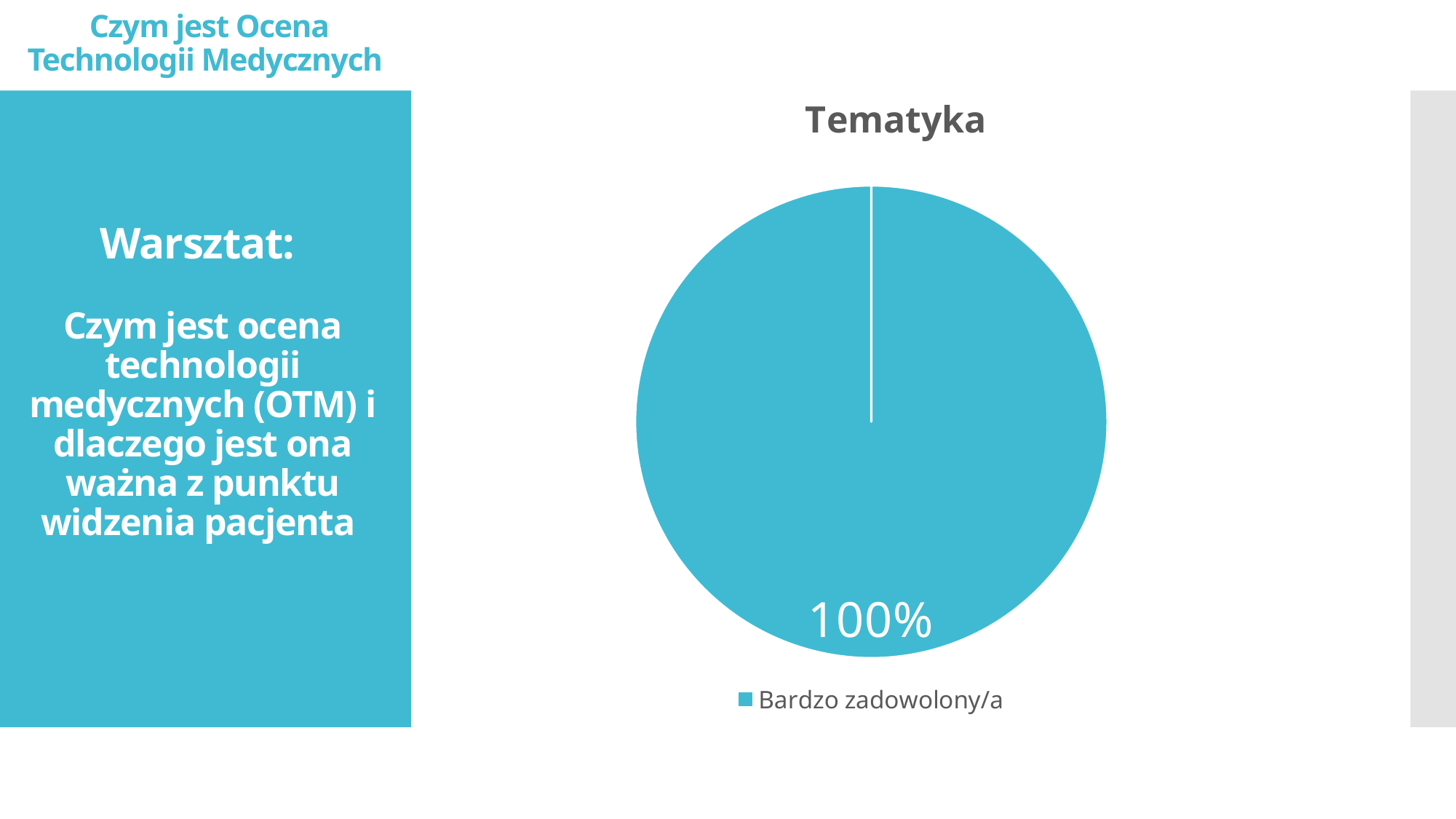
How many slices does the pie chart have? 1 What share of the pie does the "Bardzo zadowolony/a" slice represent? 100% What is the title of the chart? Tematyka What value is printed on the pie slice? 100% What is the legend entry for the pie chart? Bardzo zadowolony/a How many entries does the legend list? 1 What kind of chart is shown on the slide? pie chart Which category has the largest share of the pie? Bardzo zadowolony/a